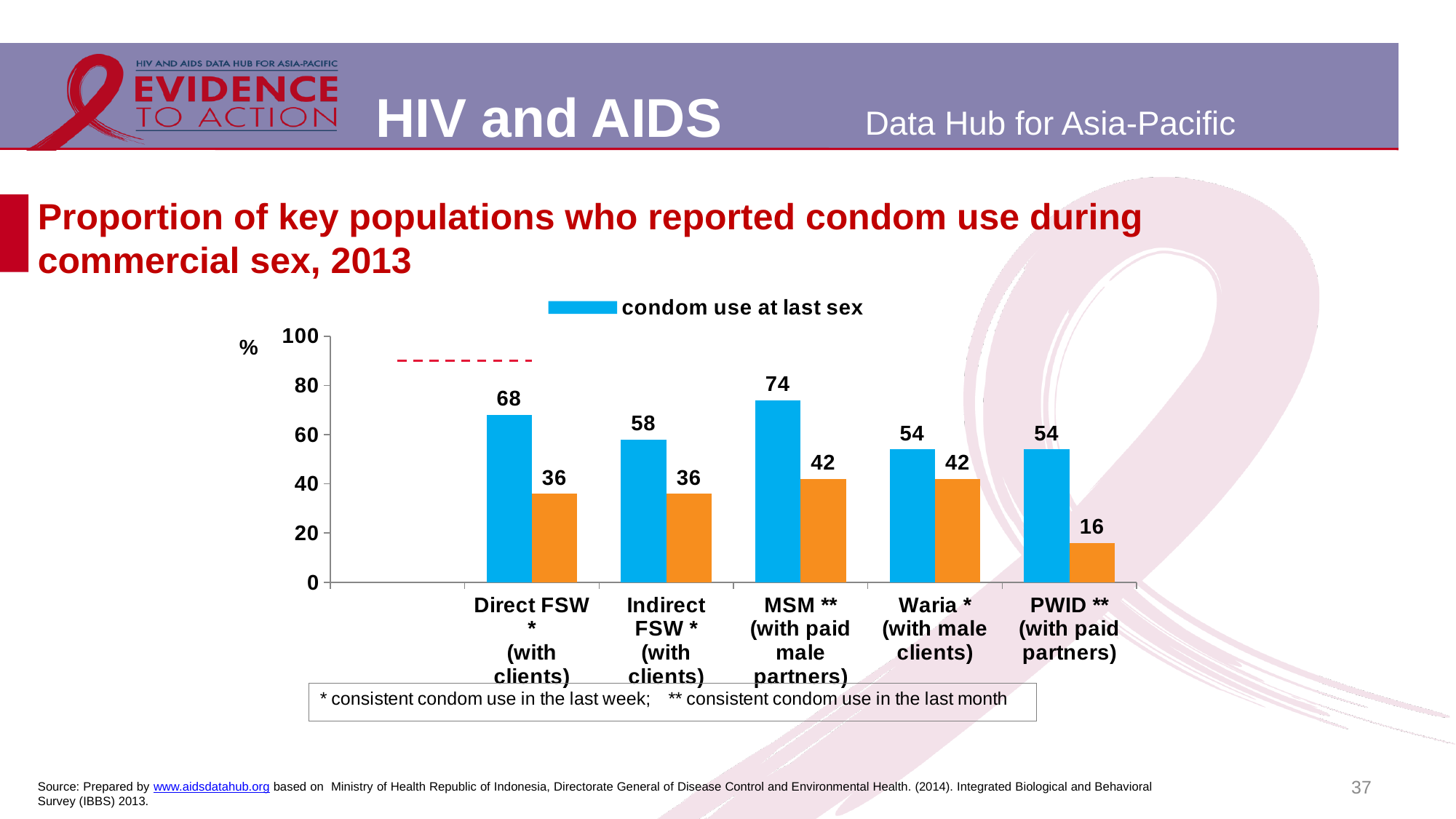
What is the value of the orange bar for PWID (with paid partners)? 16 How many key population categories are shown on the x axis? 5 What is the value of the orange bar for Waria (with male clients)? 42 Is the value for condom use at last sex among MSM (with paid male partners) greater or less than 60? greater What is the difference in condom use at last sex between MSM (with paid male partners) and Waria (with male clients)? 20 Which key population has the lowest orange bar value? PWID ** (with paid partners) What kind of chart is shown on the slide? bar chart Which has a higher value for condom use at last sex: Direct FSW (with clients) or Indirect FSW (with clients)? Direct FSW (with clients) Which key population has the highest value for condom use at last sex? MSM ** (with paid male partners) What is the difference between the blue bar and the orange bar for Direct FSW (with clients)? 32 What is the value for condom use at last sex among Direct FSW (with clients)? 68 What is the value for condom use at last sex among MSM (with paid male partners)? 74